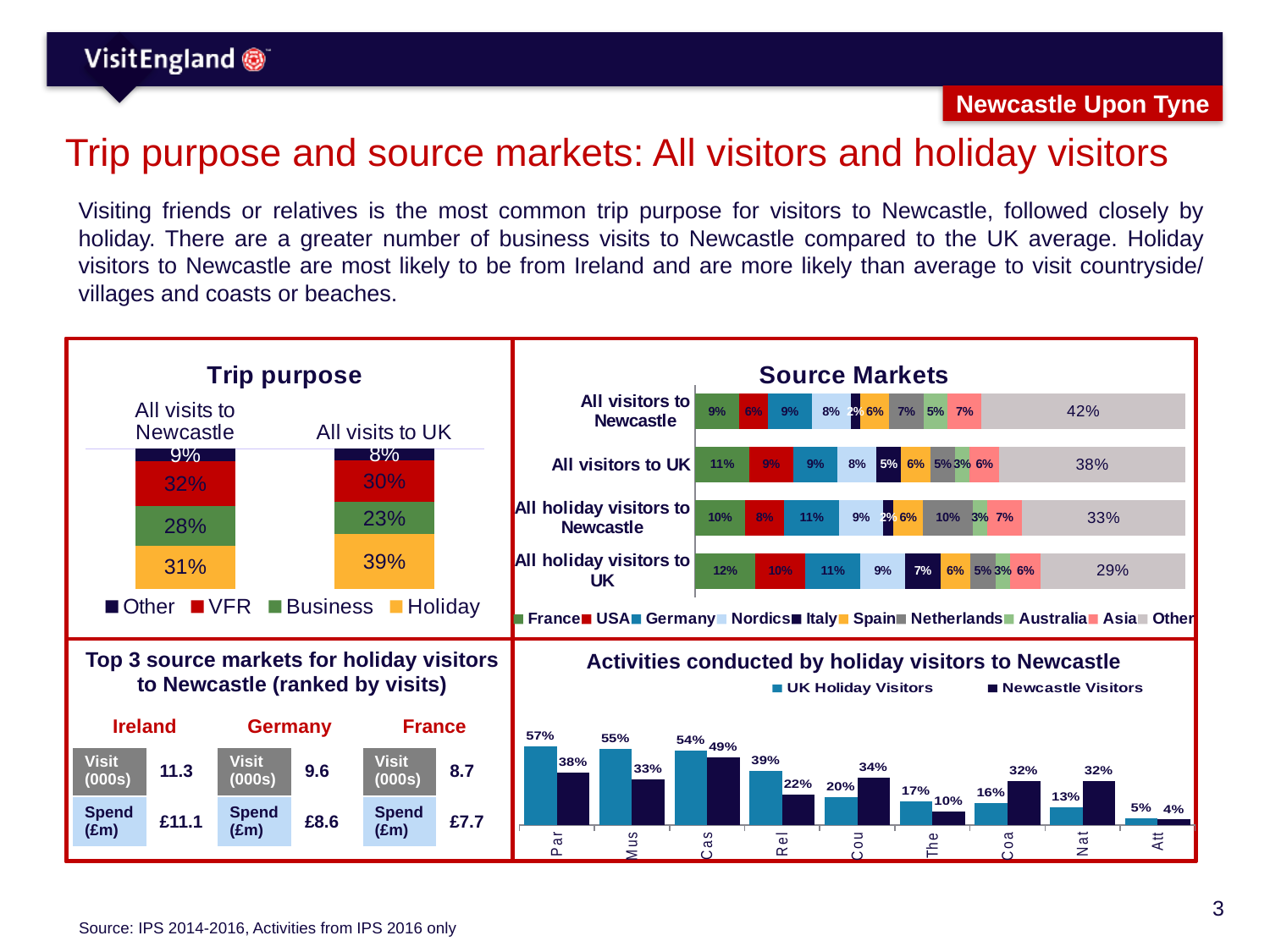
How many series does the legend of the Source Markets chart list? 10 In the Trip purpose chart, what share of all visits to the UK are VFR? 30% What kind of chart is the Activities conducted by holiday visitors to Newcastle chart? Bar chart In the Source Markets chart, which bar has the lowest 'Other' share? All holiday visitors to UK How many activity categories are shown in the Activities conducted by holiday visitors to Newcastle chart? 9 In the Trip purpose chart, what is the difference between the Business share for all visits to Newcastle and for all visits to the UK? 5 percentage points In the Trip purpose chart, which is larger: the Holiday share for all visits to Newcastle or for all visits to the UK? All visits to UK In the Source Markets chart, what share of all visitors to Newcastle come from the 'Other' markets? 42% In the Trip purpose chart, what share of all visits to Newcastle are for Holiday? 31% In the Source Markets chart, what share of all holiday visitors to Newcastle come from Germany? 11% In the Activities conducted by holiday visitors to Newcastle chart, what is the highest value for UK Holiday Visitors? 57% How many series does the legend of the Trip purpose chart list? 4